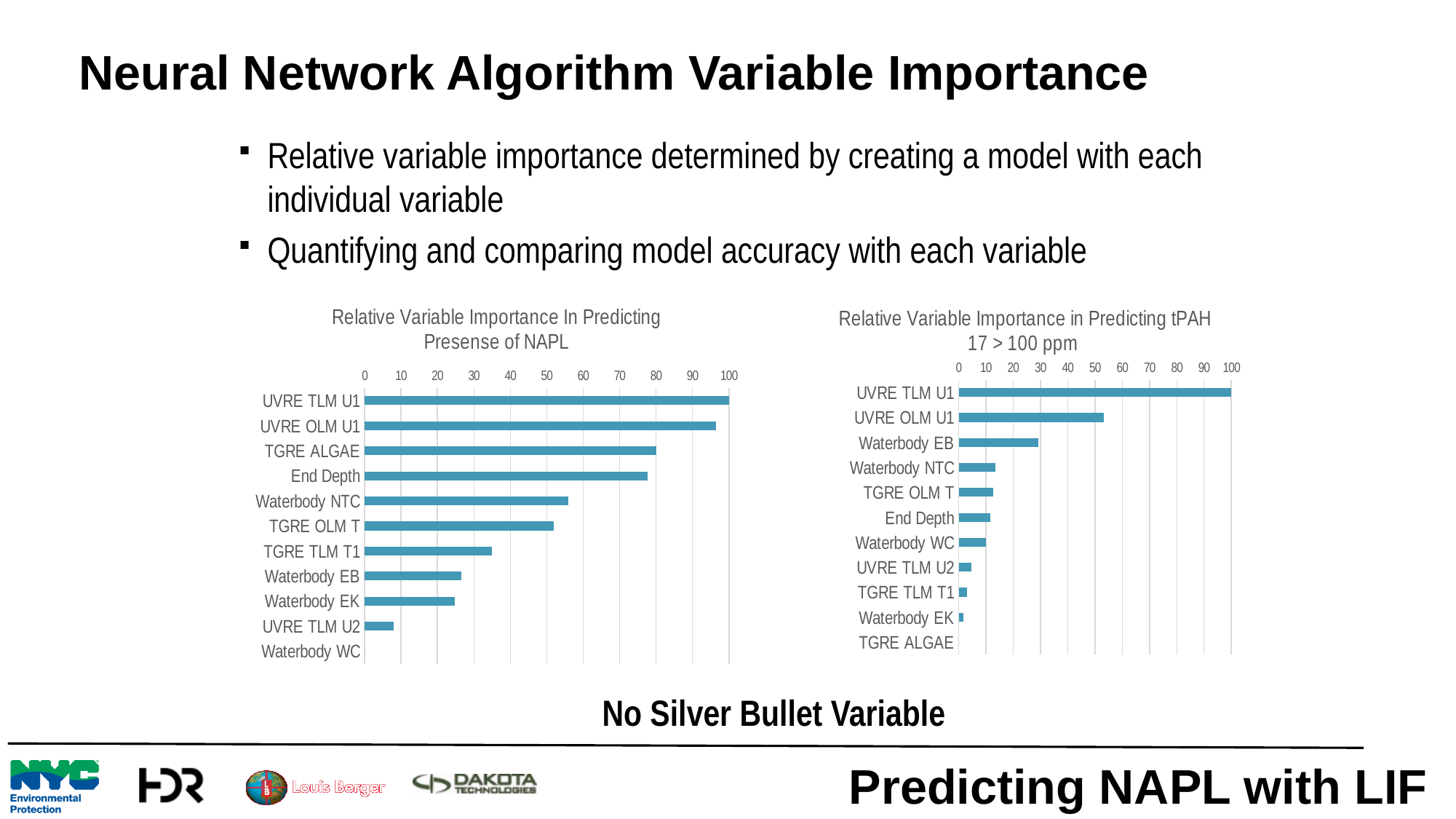
In the left chart (Predicting Presense of NAPL), which variable has the lowest importance? Waterbody WC What is the title of the right chart? Relative Variable Importance in Predicting tPAH 17 > 100 ppm In the left chart (Predicting Presense of NAPL), which variable has the highest importance? UVRE TLM U1 In the right chart (Predicting tPAH 17 > 100 ppm), which is larger, Waterbody EB or Waterbody WC? Waterbody EB What kind of chart is the left chart, 'Relative Variable Importance In Predicting Presense of NAPL'? Bar chart How many variables are listed in the left chart (Predicting Presense of NAPL)? 11 In the left chart (Predicting Presense of NAPL), is the value for UVRE TLM U2 greater or less than 20? less In the right chart (Predicting tPAH 17 > 100 ppm), is the value for UVRE OLM U1 greater or less than 40? greater In the right chart (Predicting tPAH 17 > 100 ppm), which variable has the highest importance? UVRE TLM U1 In the right chart (Predicting tPAH 17 > 100 ppm), which variable has the lowest importance? TGRE ALGAE In the left chart (Predicting Presense of NAPL), is the value for TGRE ALGAE greater or less than 70? greater In the left chart (Predicting Presense of NAPL), which is larger, Waterbody NTC or TGRE TLM T1? Waterbody NTC